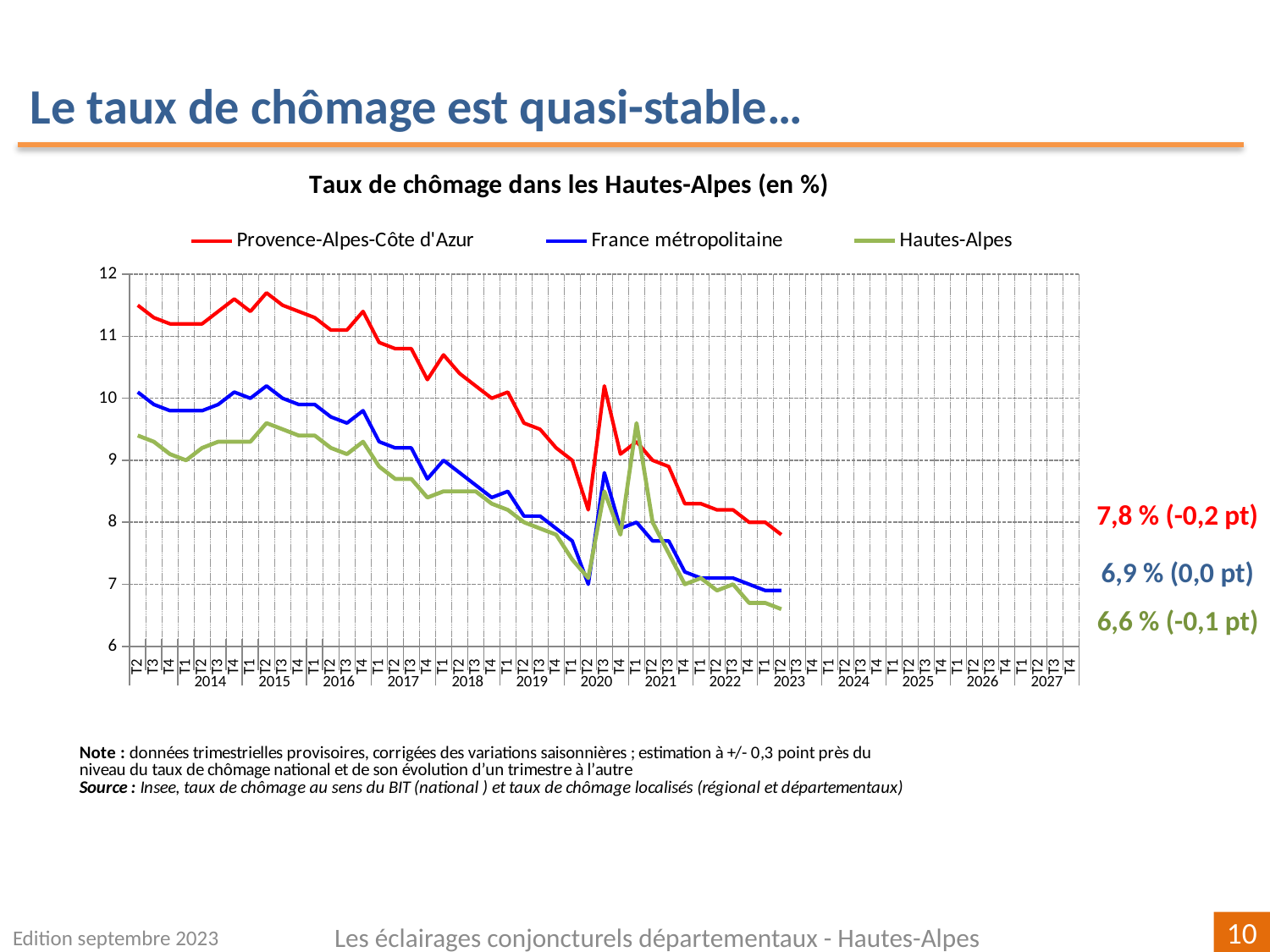
What is the latest unemployment rate shown for Provence-Alpes-Côte d'Azur? 7,8 % Overall, does the Provence-Alpes-Côte d'Azur line rise or fall from 2014 to 2023? fall At the end of the chart, is the France métropolitaine rate higher or lower than the Hautes-Alpes rate? higher Which series has the highest value at the end of the chart? Provence-Alpes-Côte d'Azur What is the difference between the latest Provence-Alpes-Côte d'Azur rate and the latest Hautes-Alpes rate? 1,2 points Is the Hautes-Alpes value at its T1 2021 peak greater or less than 9? greater Which series has the lowest value at the end of the chart? Hautes-Alpes How many series does the legend list? 3 What is the latest unemployment rate shown for France métropolitaine? 6,9 % What kind of chart is shown on the slide? line chart What quarterly change is indicated next to the latest Provence-Alpes-Côte d'Azur value? -0,2 pt What is the latest unemployment rate shown for Hautes-Alpes? 6,6 %